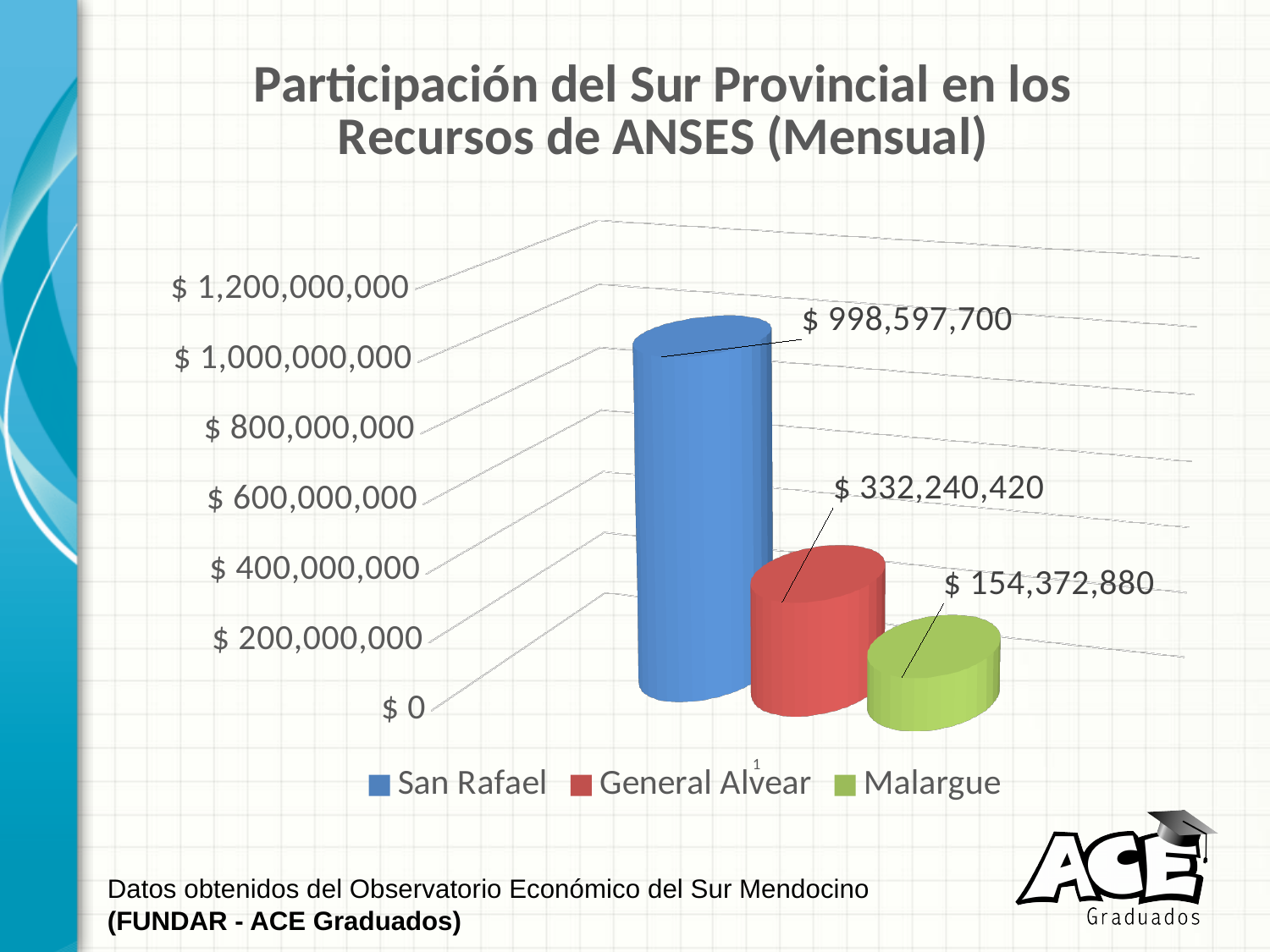
Is the value for San Rafael greater or less than $ 800,000,000? greater How many series does the legend list? 3 What is the value for San Rafael? $ 998,597,700 Which series has the lowest value? Malargue Which is larger, the value for General Alvear or the value for Malargue? General Alvear What is the value for General Alvear? $ 332,240,420 What is the difference between the values for San Rafael and General Alvear? $ 666,357,280 What is the difference between the values for General Alvear and Malargue? $ 177,867,540 What is the value for Malargue? $ 154,372,880 What is the title of the chart? Participación del Sur Provincial en los Recursos de ANSES (Mensual) Which series has the highest value? San Rafael What kind of chart is shown on the slide? bar chart